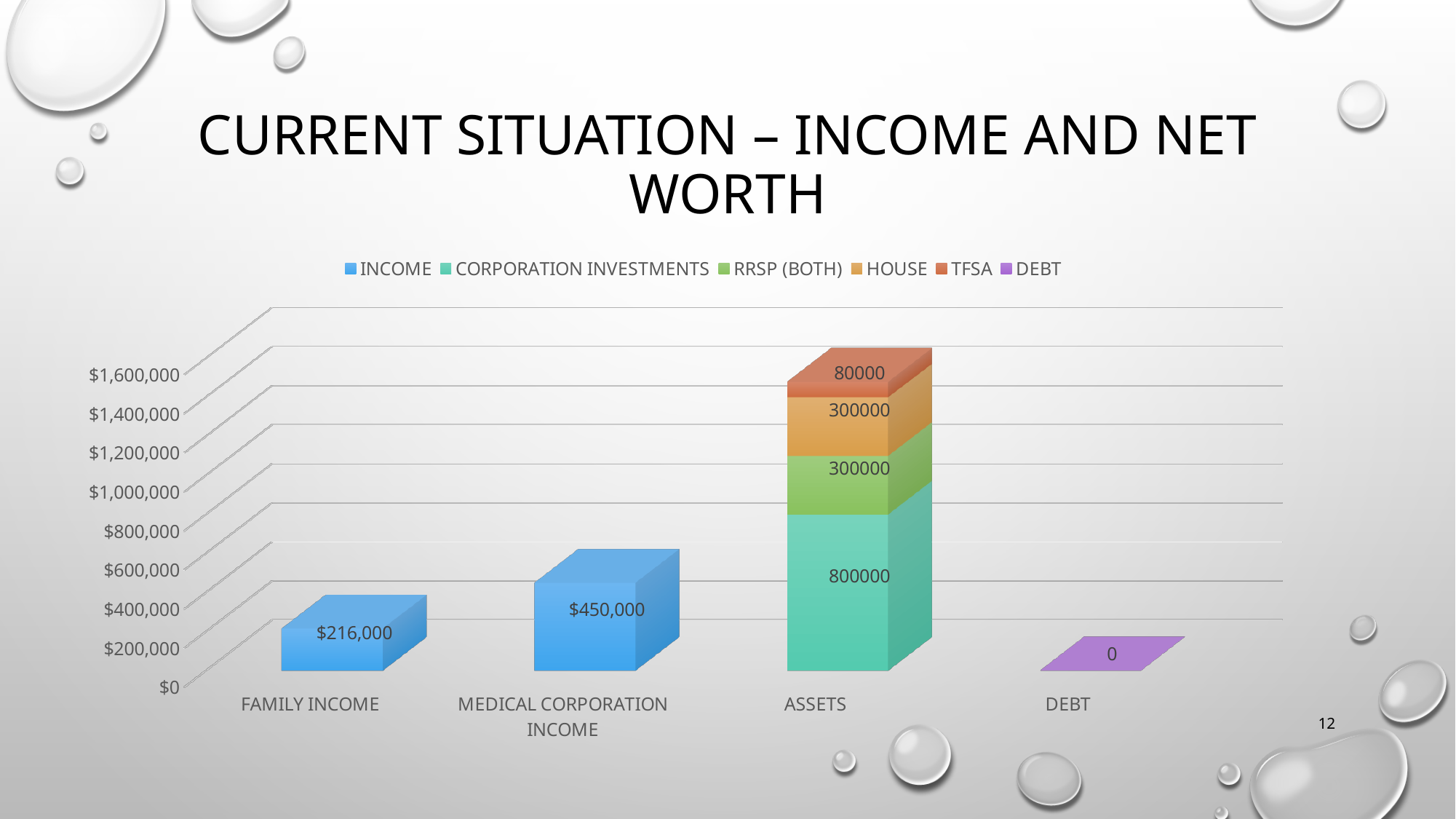
What is the Corporation Investments value in the Assets bar? 800000 What is the value shown for the Debt category? 0 How many categories are shown on the x axis? 4 What kind of chart is shown on the slide? Stacked bar chart Which is larger, the Family Income value or the Medical Corporation Income value? Medical Corporation Income What is the TFSA value in the Assets bar? 80000 What is the value of the Income bar for Family Income? $216,000 How many series does the legend list? 6 What is the total of the stacked Assets bar? 1480000 What is the difference between the Medical Corporation Income value and the Family Income value? $234,000 What is the House value in the Assets bar? 300000 What is the value of the Income bar for Medical Corporation Income? $450,000